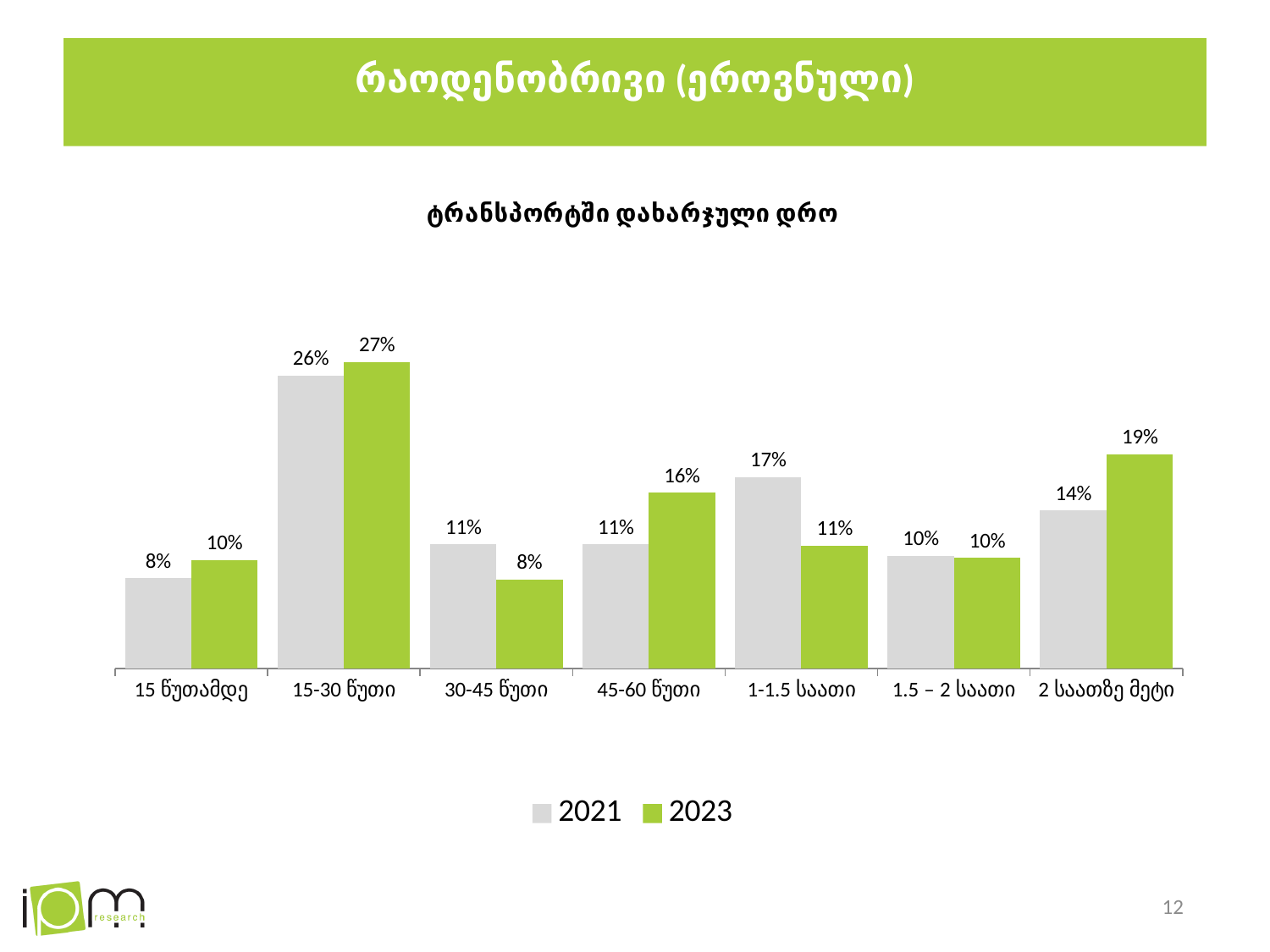
Which colour represents the 2023 series in the legend? Green What is the 2023 value for the category "30-45 წუთი"? 8% What is the 2023 value for the category "2 საათზე მეტი"? 19% What is the 2021 value for the category "1-1.5 საათი"? 17% What kind of chart is shown on the slide? Bar chart Which category has the highest 2023 value? 15-30 წუთი How many series does the legend list? 2 Which category has the lowest 2021 value? 15 წუთამდე What is the difference between the 2023 and 2021 values for "45-60 წუთი"? 5 percentage points How many categories are shown on the x axis? 7 For the category "1-1.5 საათი", which year has the larger value, 2021 or 2023? 2021 What is the title of the chart? ტრანსპორტში დახარჯული დრო